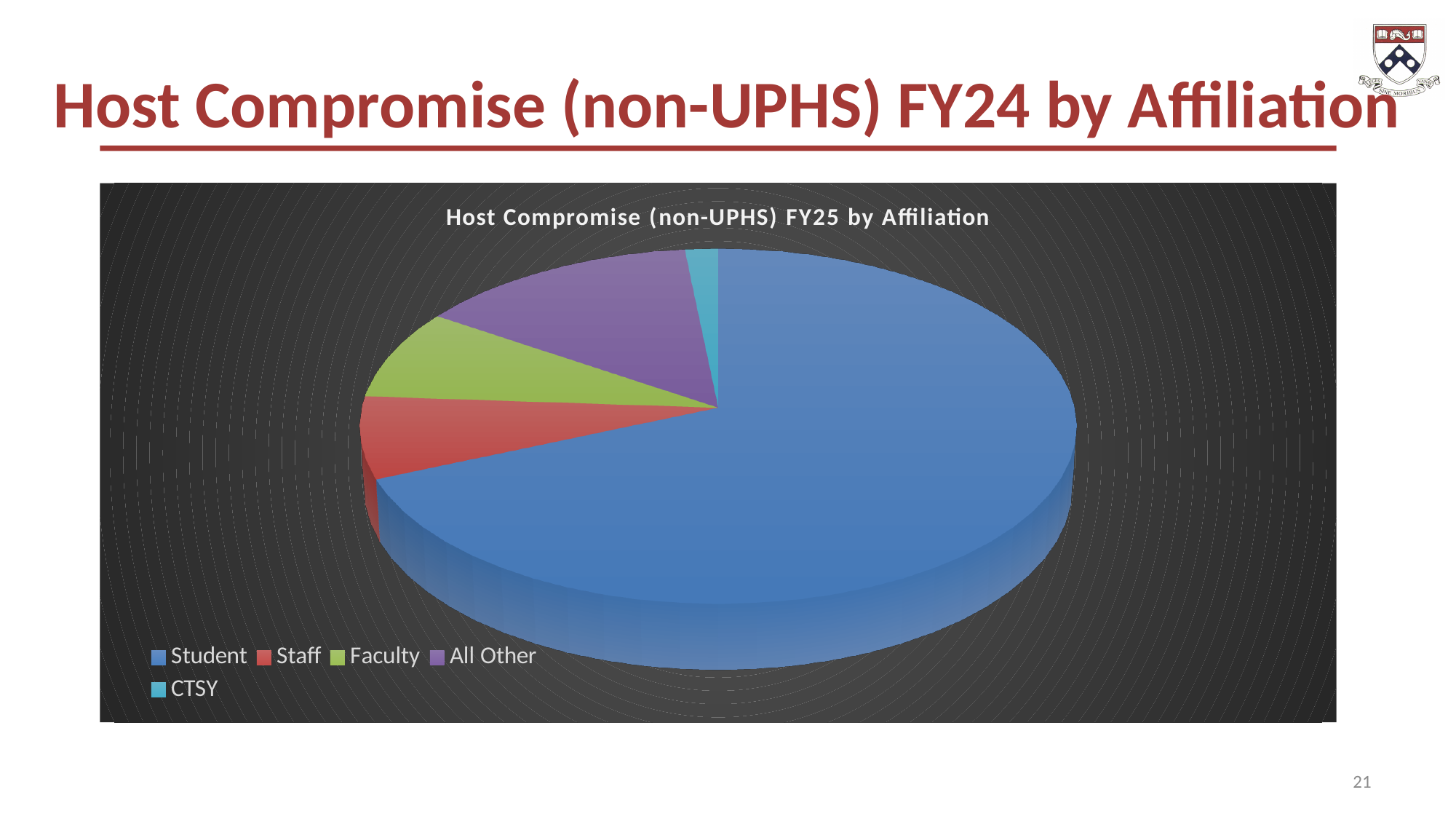
Which slice is larger, All Other or Faculty? All Other Which colour represents Faculty in the pie chart? Green What is the title printed inside the chart area? Host Compromise (non-UPHS) FY25 by Affiliation Which affiliation has the smallest slice of the pie chart? CTSY Does the Student slice account for more or less than half of the pie? More than half How many affiliation categories does the pie chart show? 5 Which affiliation has the largest slice of the pie chart? Student Which slice is larger, Student or Staff? Student Which slice is larger, All Other or CTSY? All Other What kind of chart is shown on the slide? Pie chart